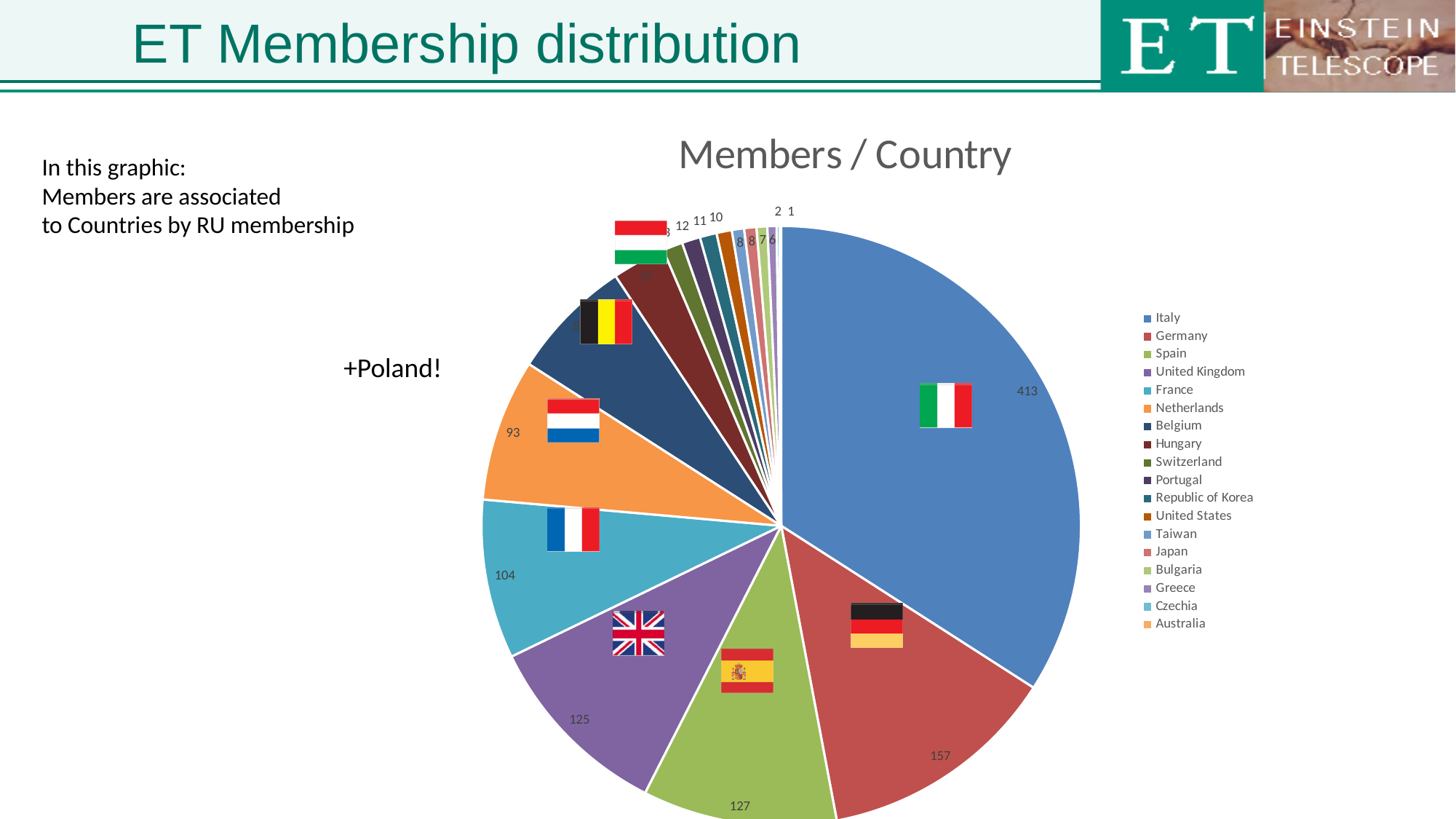
What is the value shown for the Netherlands? 93 How many members does Italy have according to the chart? 413 What kind of chart is shown on the slide? pie chart What is the difference between the values for Italy and Germany? 256 How many countries are listed in the chart's legend? 18 Which country has the largest slice of the pie? Italy What is the value shown for the United Kingdom? 125 Which has a larger value, Spain or the United Kingdom? Spain What is the title of the chart? Members / Country What is the value shown for France? 104 How many members does Germany have according to the chart? 157 What is the value shown for Spain? 127